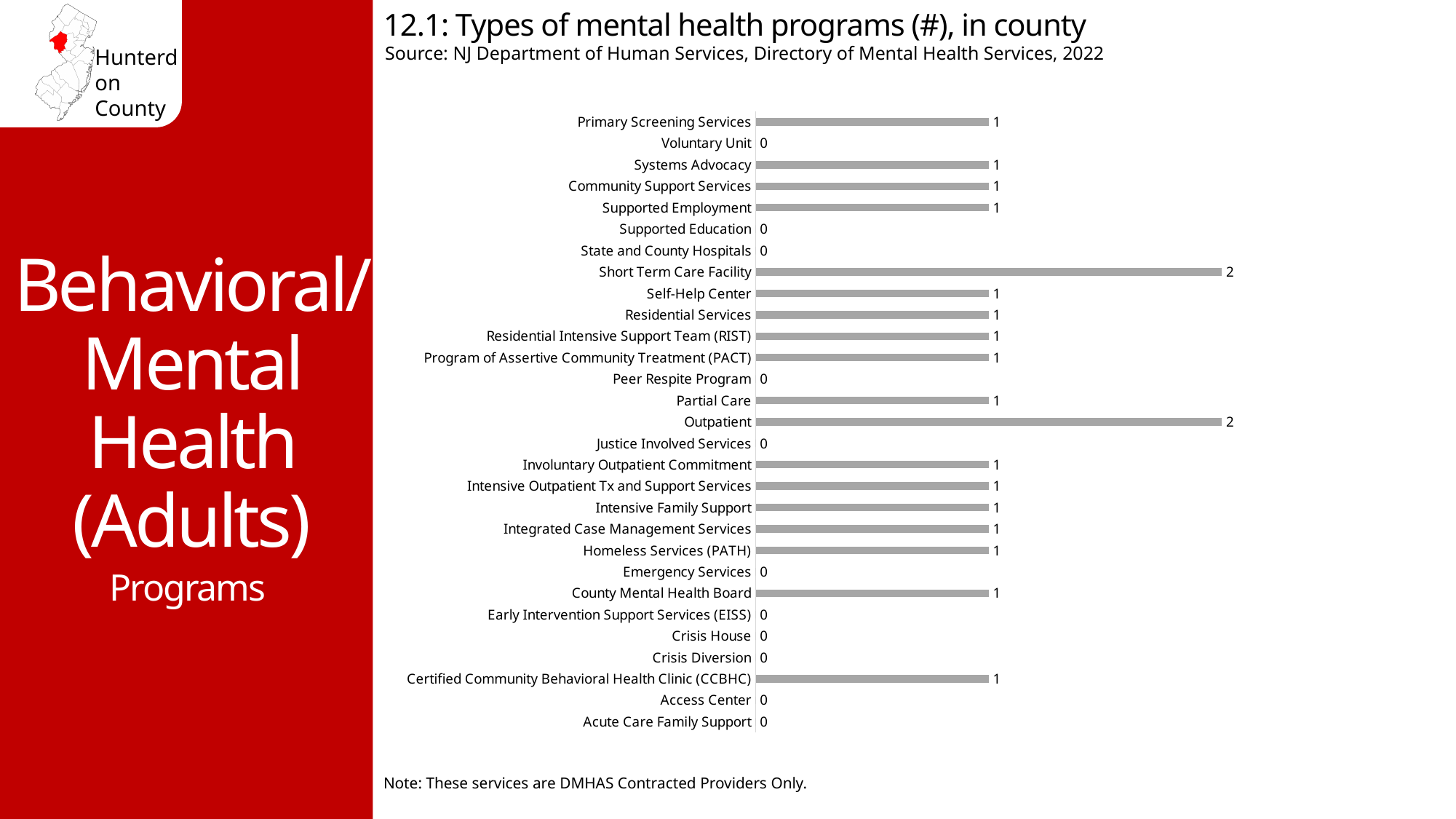
What is the value for Outpatient? 2 What is the value for Short Term Care Facility? 2 What is the title of the chart? 12.1: Types of mental health programs (#), in county What is the difference between the value for Outpatient and the value for Partial Care? 1 Which two categories share the highest value on the chart? Short Term Care Facility and Outpatient How many categories have a value of 0? 11 What is the value for Voluntary Unit? 0 How many categories are shown on the chart? 29 What is the value for Homeless Services (PATH)? 1 What kind of chart is shown on the slide? Bar chart What is the value for Certified Community Behavioral Health Clinic (CCBHC)? 1 Which is larger, the value for Short Term Care Facility or the value for Self-Help Center? Short Term Care Facility